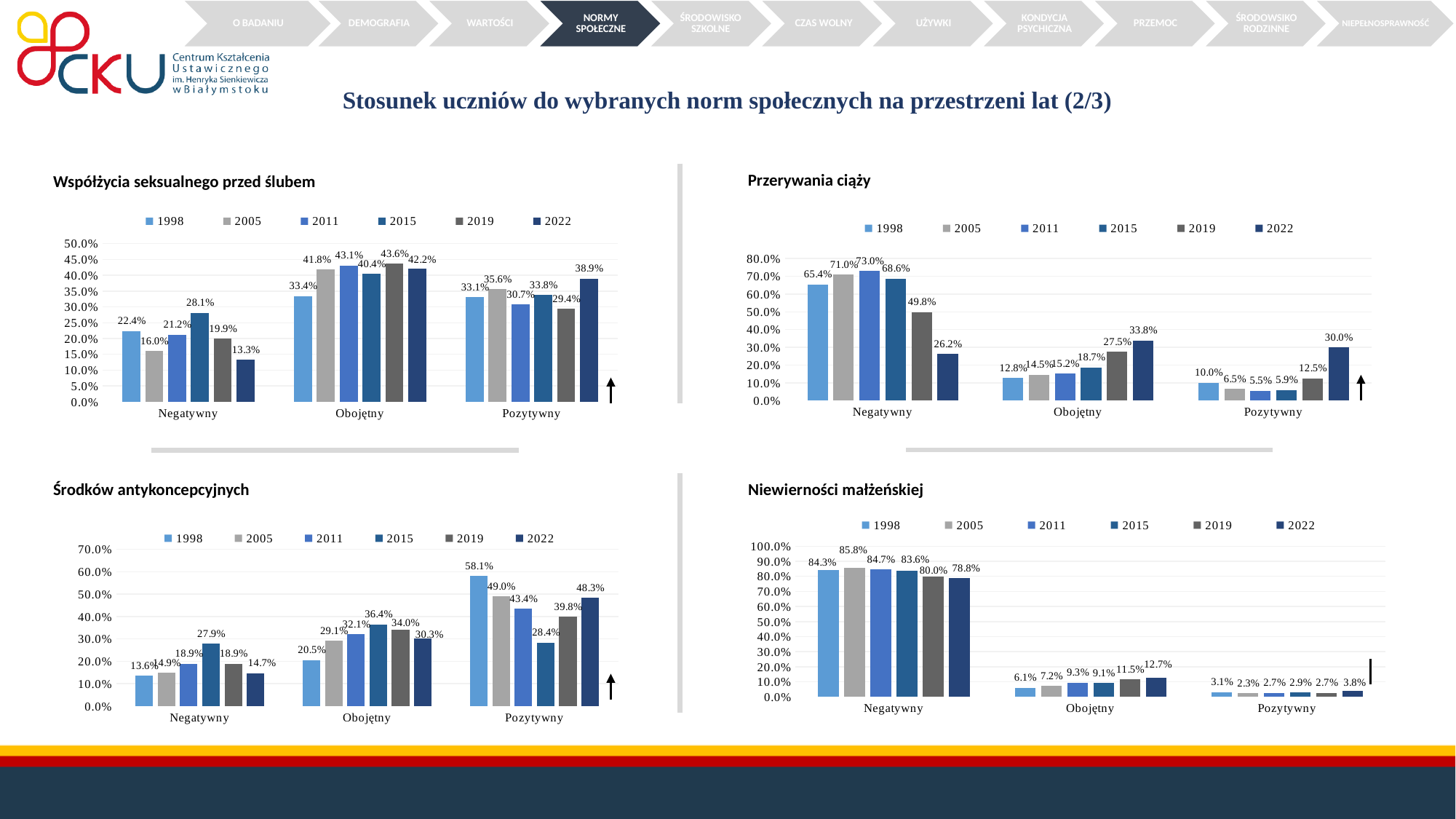
In the chart titled "Współżycia seksualnego przed ślubem", what is the value for 2022 in the Pozytywny category? 38.9% In the chart titled "Przerywania ciąży", what is the difference between the 2011 and 2022 values in the Negatywny category? 46.8 percentage points In the chart titled "Środków antykoncepcyjnych", which is larger in the Obojętny category: the 2015 value or the 2022 value? 2015 In the chart titled "Środków antykoncepcyjnych", what is the value for 1998 in the Pozytywny category? 58.1% In the chart titled "Niewierności małżeńskiej", what is the value for 2005 in the Negatywny category? 85.8% What kind of chart is the chart titled "Przerywania ciąży"? bar chart How many categories are shown on the x axis of the chart titled "Środków antykoncepcyjnych"? 3 In the chart titled "Przerywania ciąży", which year has the highest value in the Pozytywny category? 2022 In the chart titled "Współżycia seksualnego przed ślubem", which year has the lowest value in the Negatywny category? 2022 How many series does the legend list in the chart titled "Niewierności małżeńskiej"? 6 In the chart titled "Przerywania ciąży", what is the value for 1998 in the Negatywny category? 65.4% In the chart titled "Niewierności małżeńskiej", do the values in the Obojętny category generally rise or fall from 1998 to 2022? rise